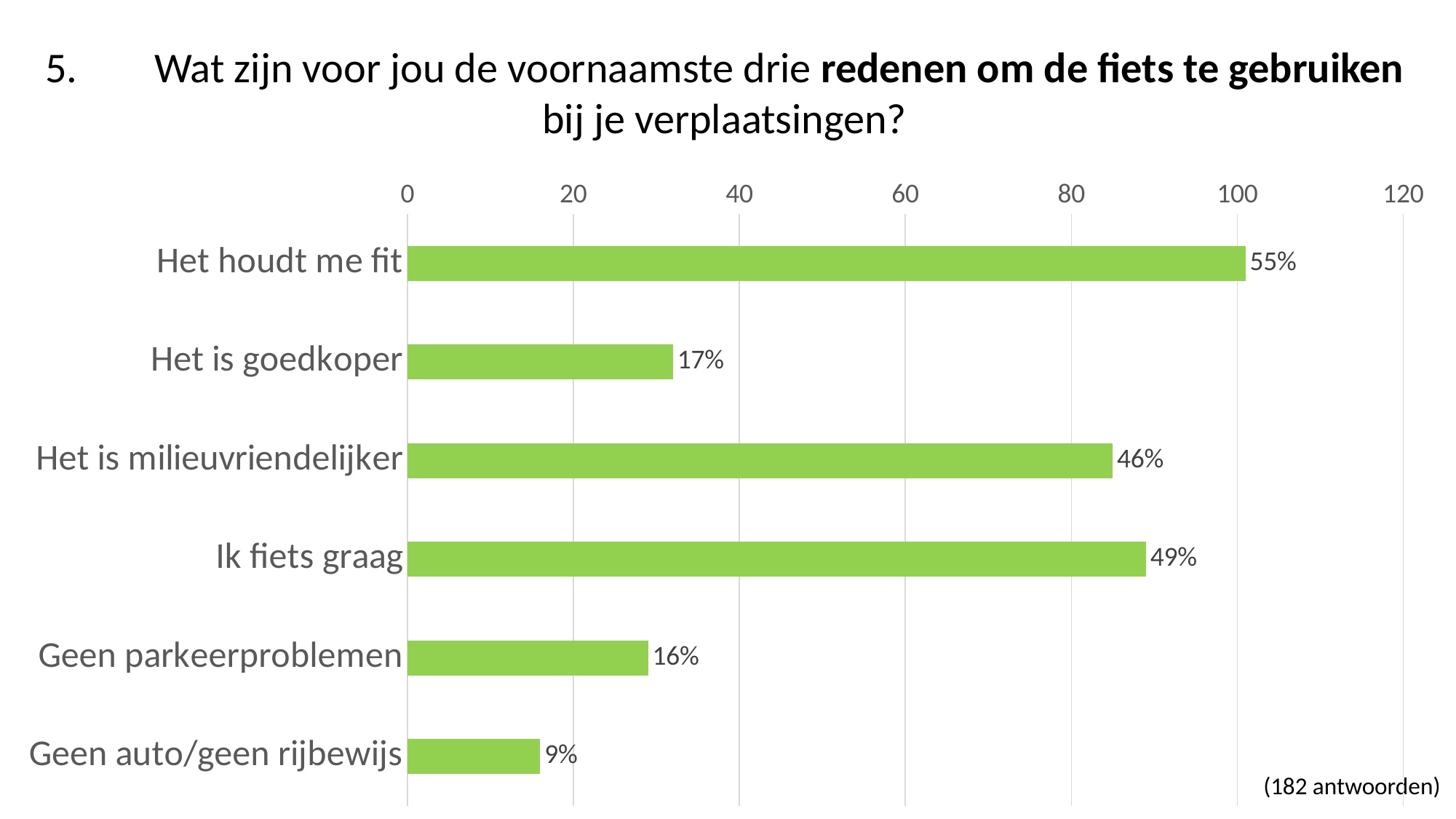
Which category has the lowest value? Geen auto/geen rijbewijs Is the bar for "Het is goedkoper" greater or less than 40 on the axis? less Which category has the highest value? Het houdt me fit Which is larger: "Ik fiets graag" or "Het is milieuvriendelijker"? Ik fiets graag What is the data label shown for "Geen parkeerproblemen"? 16% Is the bar for "Ik fiets graag" greater or less than 80 on the axis? greater How many responses does the note at the bottom right of the slide say the chart is based on? 182 antwoorden What is the data label shown for "Het is milieuvriendelijker"? 46% How many categories are shown in the chart? 6 What is the difference in percentage points between the labels for "Het houdt me fit" (55%) and "Het is goedkoper" (17%)? 38 percentage points What is the data label shown for "Het houdt me fit"? 55% What kind of chart is shown on the slide? Bar chart